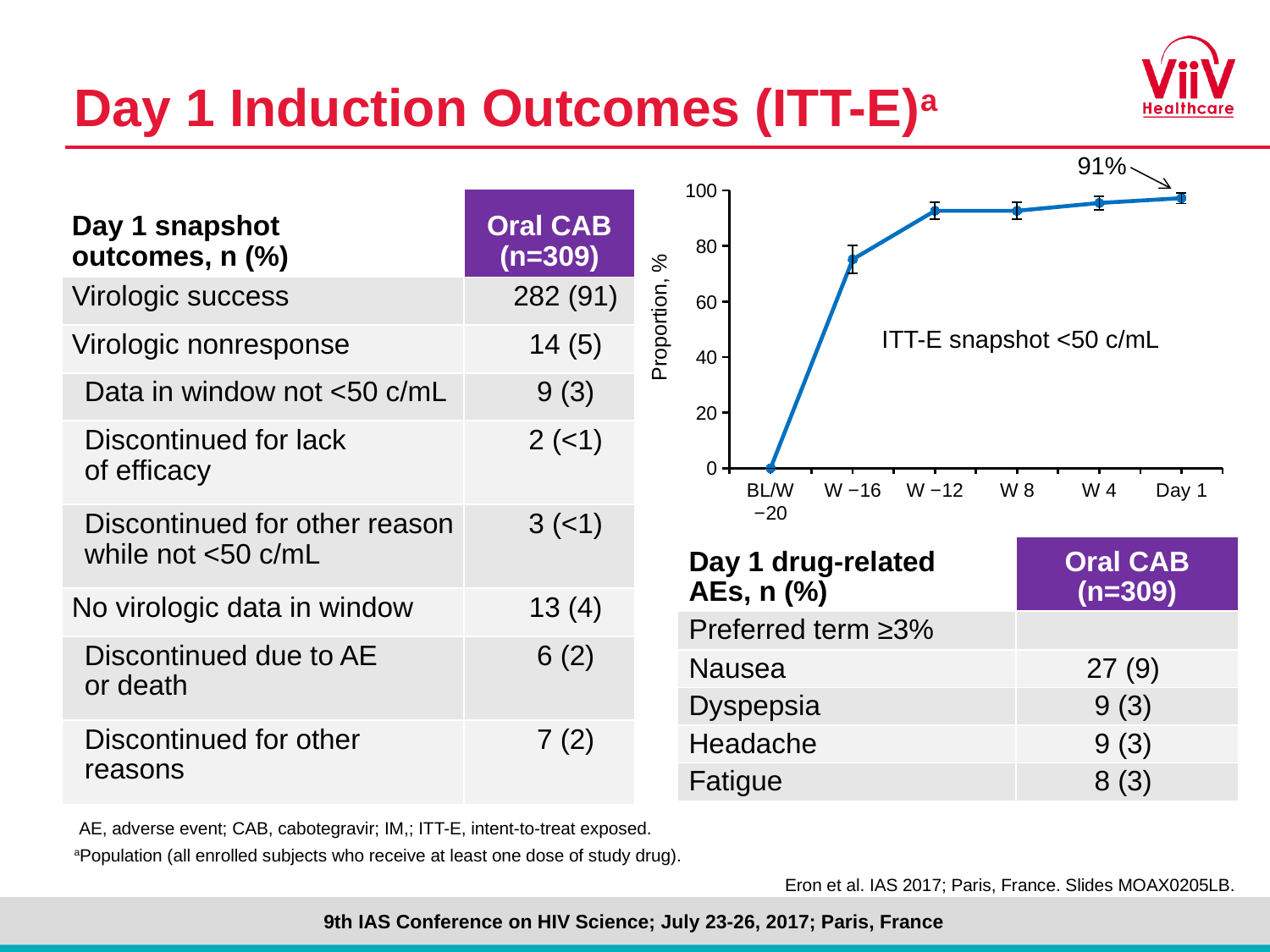
Is the value at W −12 greater or less than 80? greater Is the value at W −16 greater or less than 60? greater What is the plotted value at BL/W −20 on the chart? 0 Do the plotted values rise or fall from BL/W −20 to Day 1? rise What is the label on the y axis of the chart? Proportion, % Is the value at W 8 greater or less than 80? greater What kind of chart is shown on the slide? line chart How many time points are plotted on the x axis of the chart? 6 Which is larger, the value at W −16 or the value at W −12? W −12 What value is labelled at Day 1 on the chart? 91% Which time point has the lowest plotted value? BL/W −20 What text annotation appears inside the plot area of the chart? ITT-E snapshot <50 c/mL